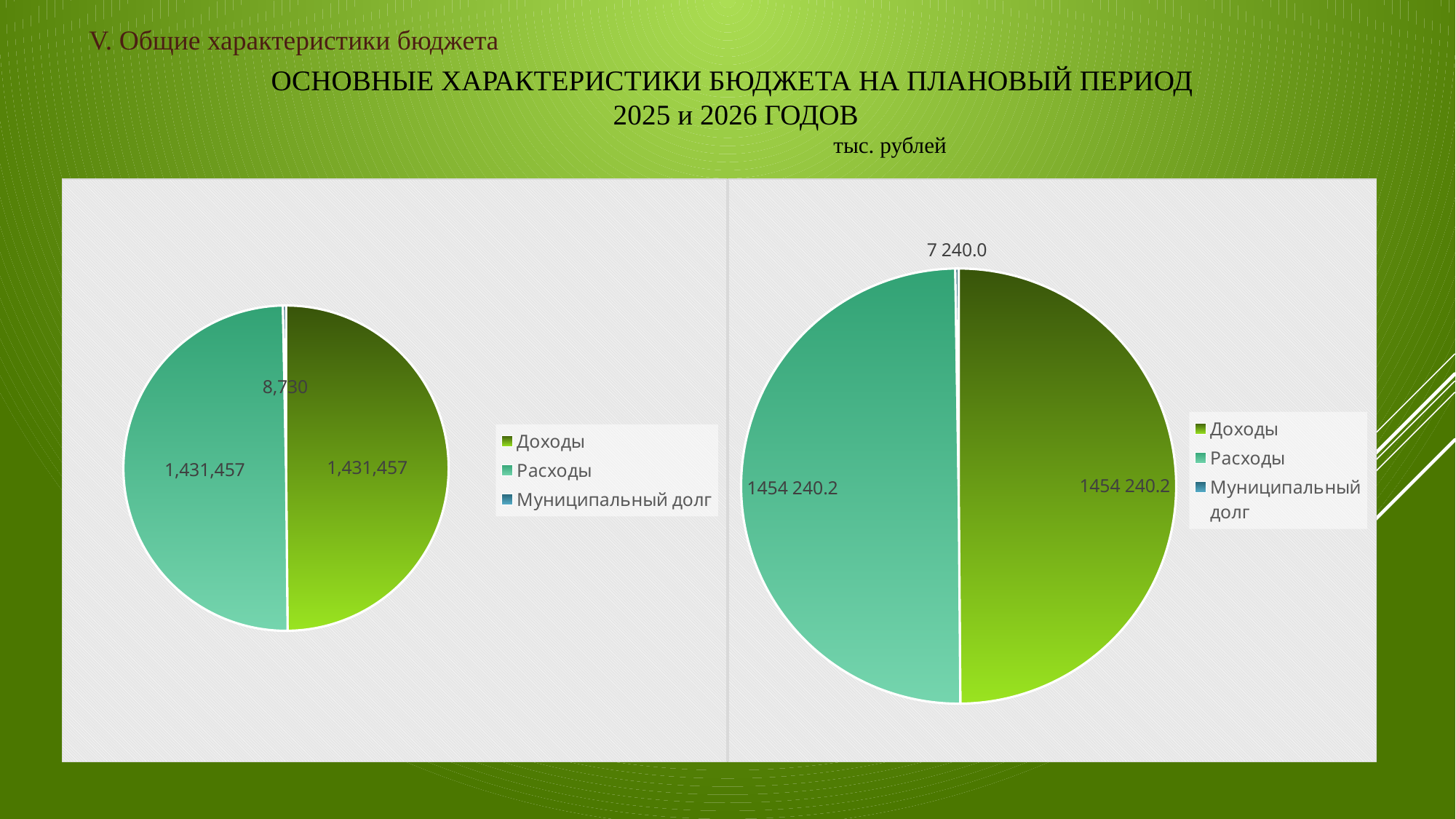
What type of chart is shown on the right side of the slide? Pie chart How many series does the legend of the right pie chart list? 3 In the left chart's legend, which category is shown in green? Доходы In the right pie chart, which category has the smallest slice? Муниципальный долг In the right pie chart, what is the value for Муниципальный долг? 7 240.0 In the left pie chart, what is the value for Доходы? 1,431,457 In the right pie chart, what is the value for Расходы? 1454 240.2 In the left pie chart, which is larger: Доходы or Муниципальный долг? Доходы In the left pie chart, what is the difference between Доходы and Муниципальный долг? 1,422,727 In the left pie chart, what is the value for Муниципальный долг? 8,730 In the left pie chart, which category has the smallest slice? Муниципальный долг How many slices does the left pie chart have? 3